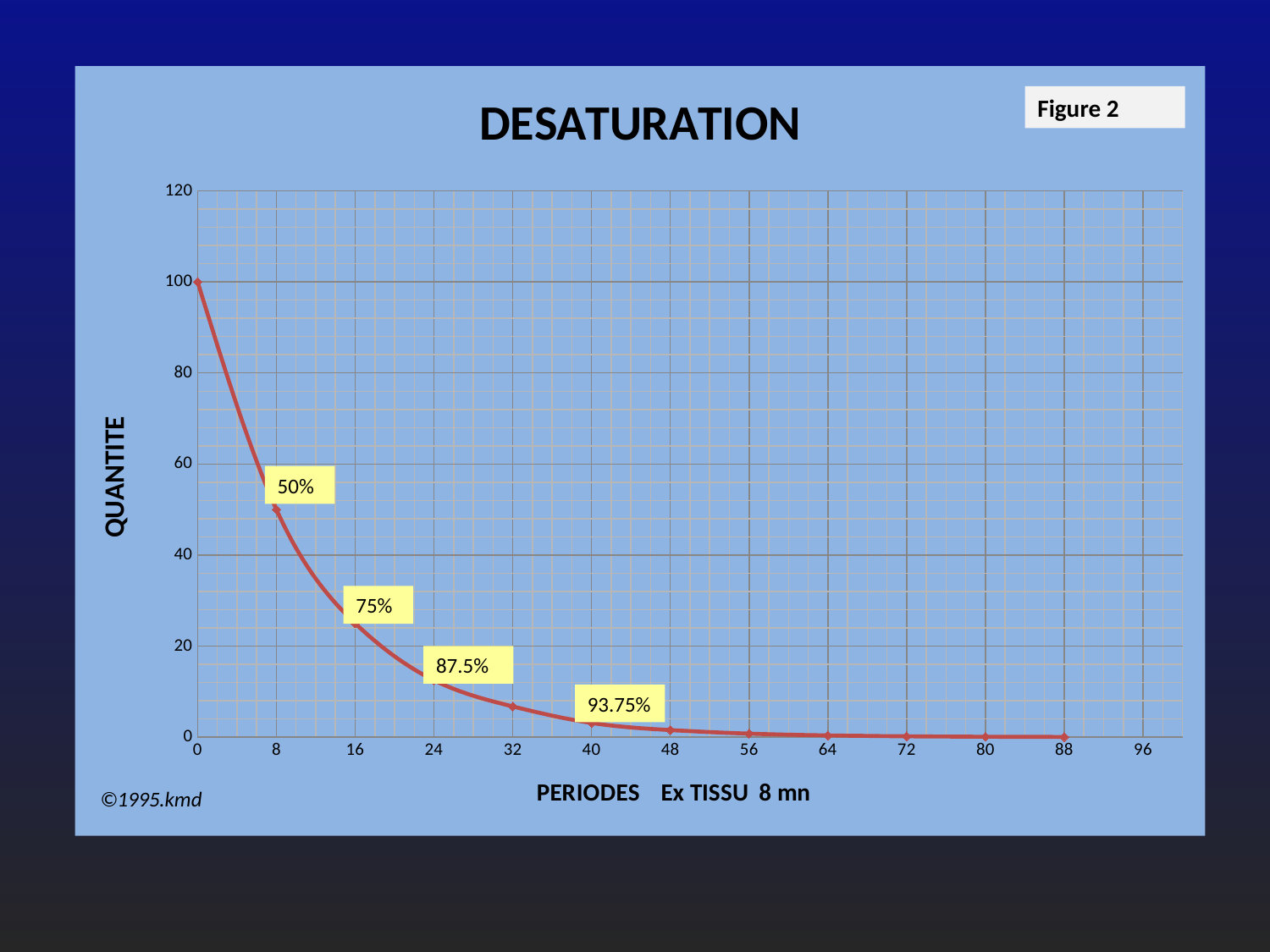
Is the value at period 24 greater or less than 20? less At which period is the value highest? 0 Is the value at period 8 greater or less than 60? less What is the title of the chart? DESATURATION Do the values rise or fall as the periods increase along the x axis? fall How many data points are plotted on the line? 12 What is the label on the y axis? QUANTITE Is the value at period 16 greater or less than 40? less Which has the larger value, period 8 or period 16? period 8 What kind of chart is shown on the slide? line chart What is the value of QUANTITE at period 0? 100